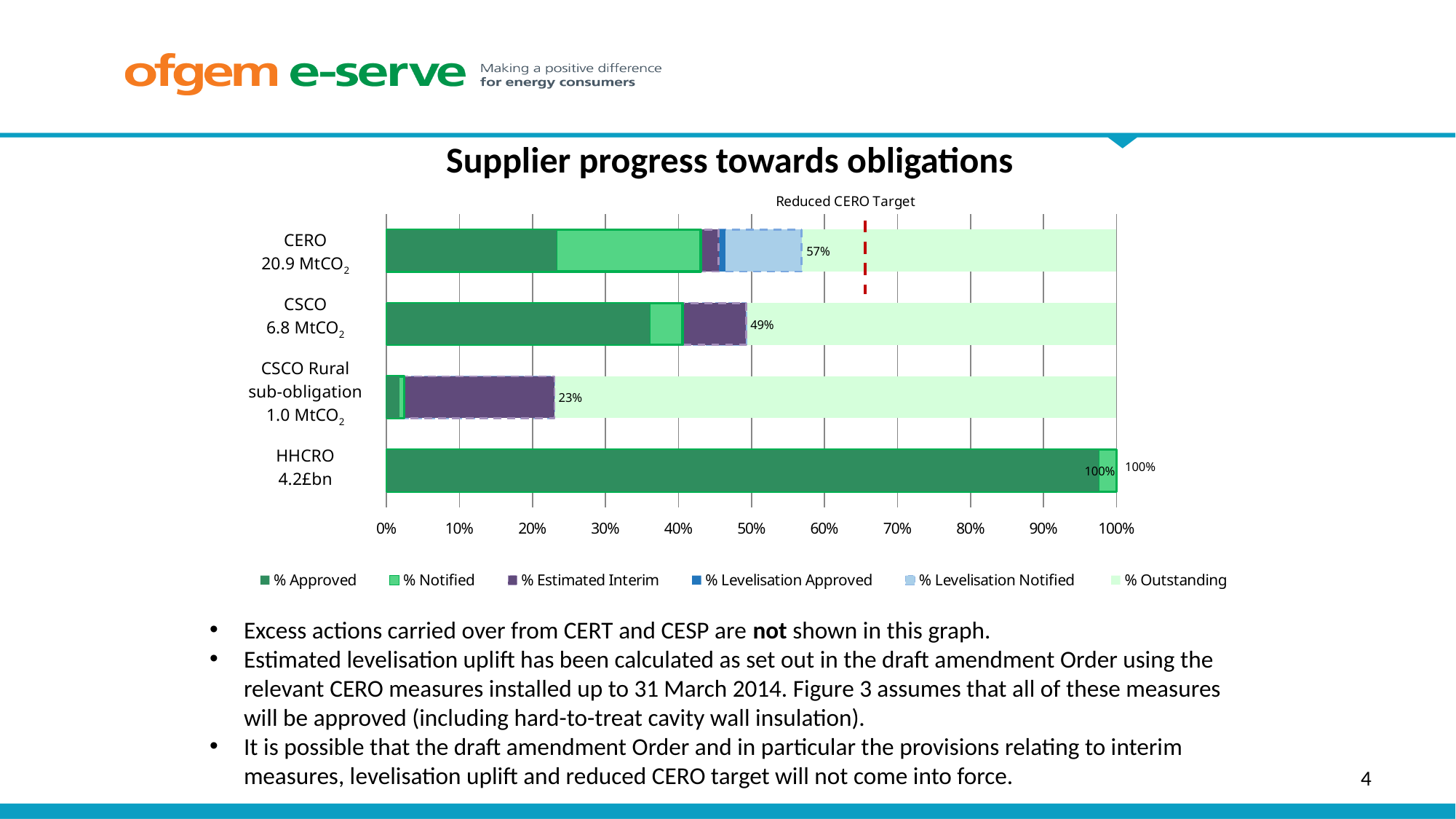
What progress percentage is labelled for the CSCO Rural sub-obligation 1.0 MtCO2? 23% What progress percentage is labelled for CERO 20.9 MtCO2? 57% How many series does the legend list? 6 Is the % Approved segment for CSCO 6.8 MtCO2 greater or less than 30%? greater Which has a higher labelled progress percentage, CSCO 6.8 MtCO2 or the CSCO Rural sub-obligation 1.0 MtCO2? CSCO 6.8 MtCO2 Which obligation shows the highest labelled progress percentage? HHCRO 4.2£bn What progress percentage is labelled for HHCRO 4.2£bn? 100% What type of chart is shown on the slide? bar chart What is the difference in percentage points between the labelled progress for CERO (57%) and CSCO (49%)? 8 Which obligation shows the lowest labelled progress percentage? CSCO Rural sub-obligation 1.0 MtCO2 How many obligation categories are plotted on the chart? 4 What progress percentage is labelled for CSCO 6.8 MtCO2? 49%